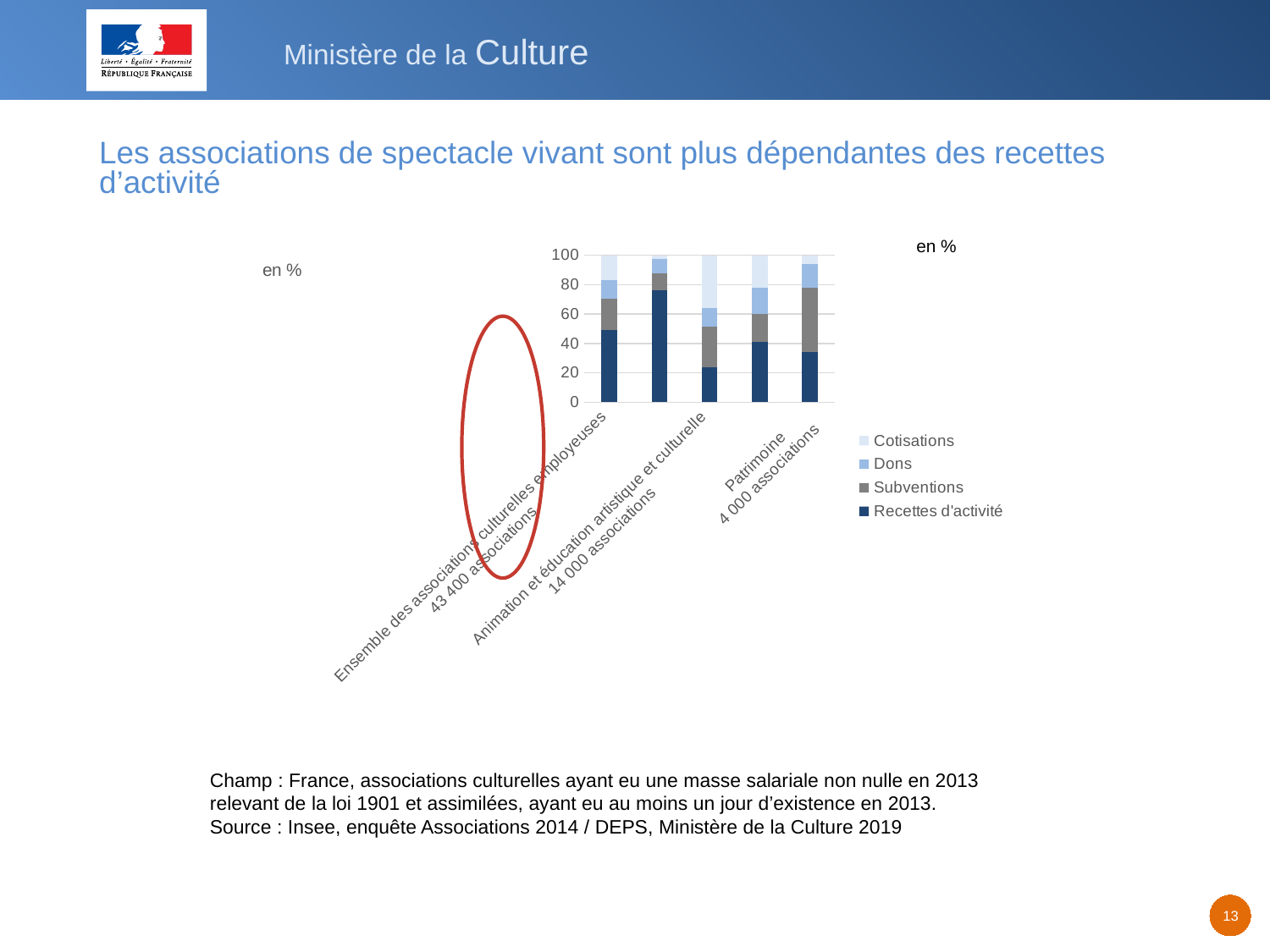
What is the highest value shown on the vertical axis? 100 Which has the larger Recettes d'activité share: Ensemble des associations culturelles employeuses or Animation et éducation artistique et culturelle? Ensemble des associations culturelles employeuses Is the Recettes d'activité value for Animation et éducation artistique et culturelle greater or less than 40? less Which series is shown at the bottom of each stacked bar? Recettes d'activité Is the Recettes d'activité value for Patrimoine greater or less than 40? less Is the Recettes d'activité value for Ensemble des associations culturelles employeuses greater or less than 40? greater What unit is indicated for the values on the chart? en % How many series does the legend list? 4 How many bars are plotted in the chart? 5 Which has the larger Subventions share: Patrimoine or Ensemble des associations culturelles employeuses? Patrimoine What kind of chart is shown on the slide? stacked bar chart Which has the larger Recettes d'activité share: Ensemble des associations culturelles employeuses or Patrimoine? Ensemble des associations culturelles employeuses